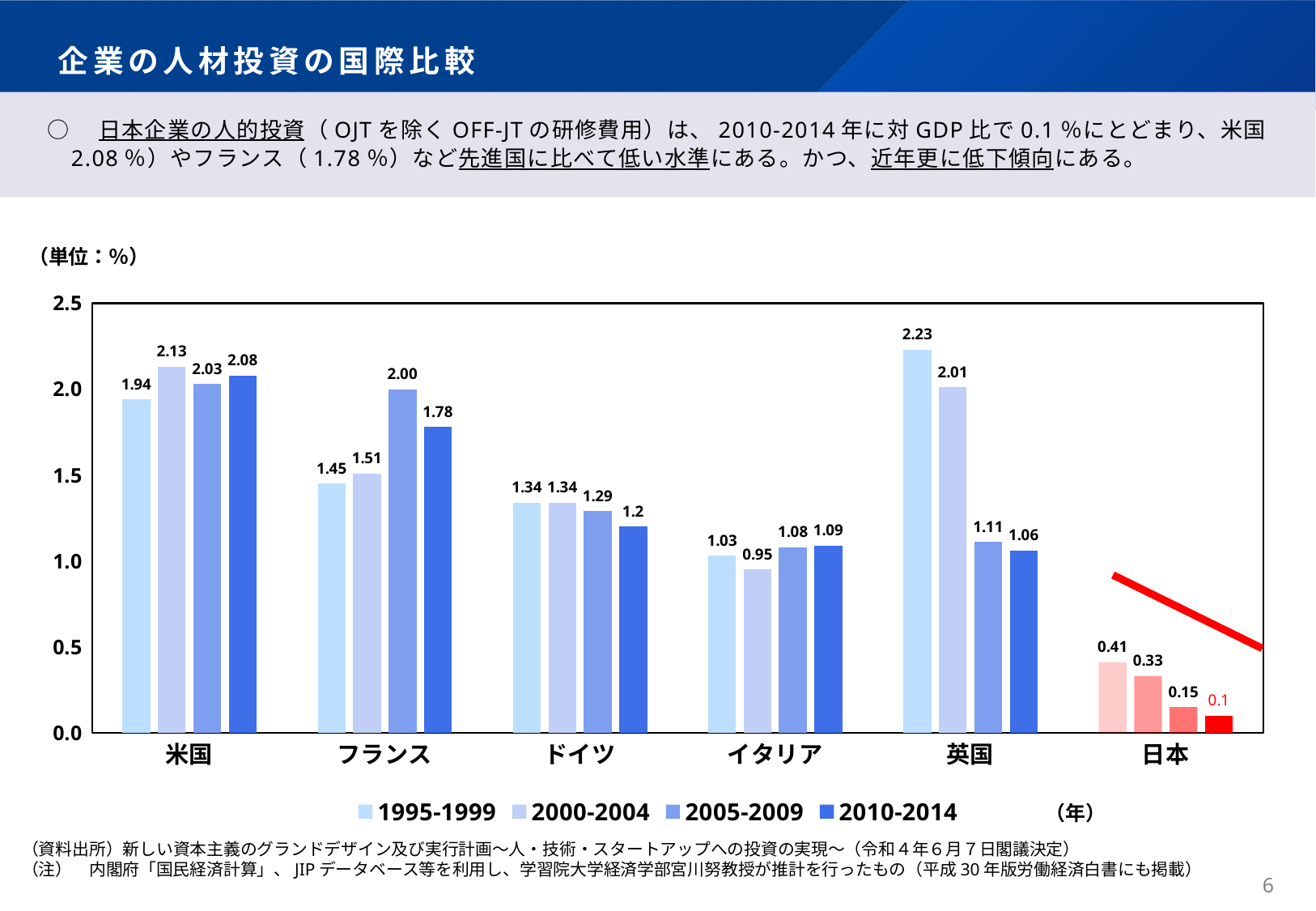
What is the value for 日本 in the 2010-2014 series? 0.1 What is the value for フランス in the 2005-2009 series? 2.00 What is the difference between the 1995-1999 and 2010-2014 values for 英国? 1.17 What is the value for 米国 in the 2000-2004 series? 2.13 What kind of chart is shown on the slide? bar chart Is the 2010-2014 value for ドイツ greater or less than 1.5? less How many series does the legend list? 4 Which is larger for イタリア: the 1995-1999 value or the 2000-2004 value? 1995-1999 Do the values for 日本 rise or fall from 1995-1999 to 2010-2014? fall Which country has the highest value in the 1995-1999 series? 英国 How many countries are shown on the x axis? 6 Which country has the lowest value in the 2010-2014 series? 日本